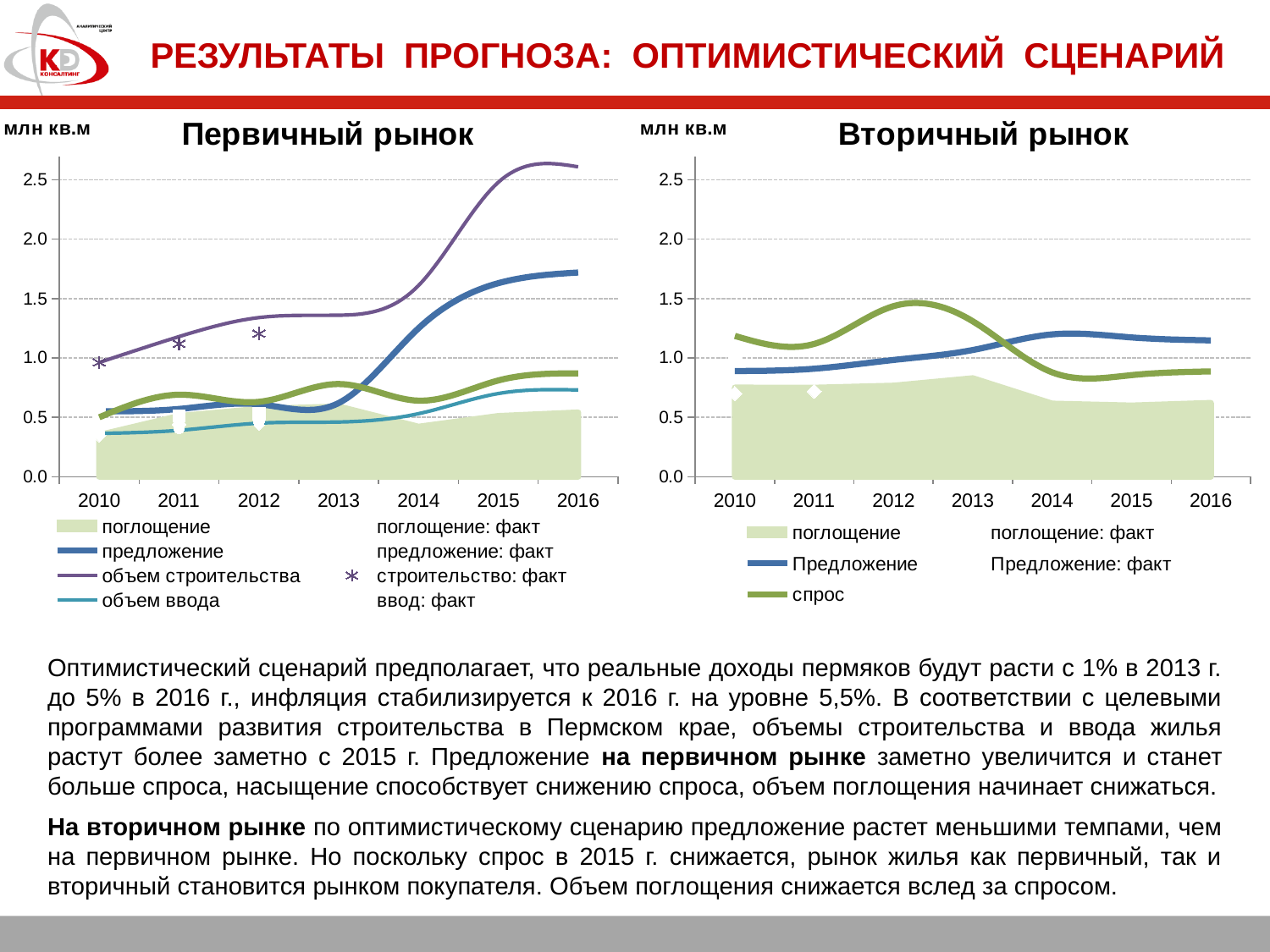
In the "Вторичный рынок" chart, is the value of "спрос" in 2012 greater or less than 1.0? greater In the "Первичный рынок" chart, which series has the highest value in 2016? объем строительства In the "Первичный рынок" chart, is the value of "предложение" in 2016 greater or less than 1.5? greater How many entries does the legend of the "Первичный рынок" chart list? 8 In the "Вторичный рынок" chart, which series has the highest value in 2012? спрос In the "Первичный рынок" chart, is the value of "объем строительства" in 2016 greater or less than 2.0? greater In the "Первичный рынок" chart, does "объем строительства" rise or fall from 2010 to 2016? rise What kind of chart is the "Первичный рынок" chart? combination area and line chart What unit is shown on the y axis of both charts? млн кв.м How many years are shown on the x axis of the "Вторичный рынок" chart? 7 How many entries does the legend of the "Вторичный рынок" chart list? 5